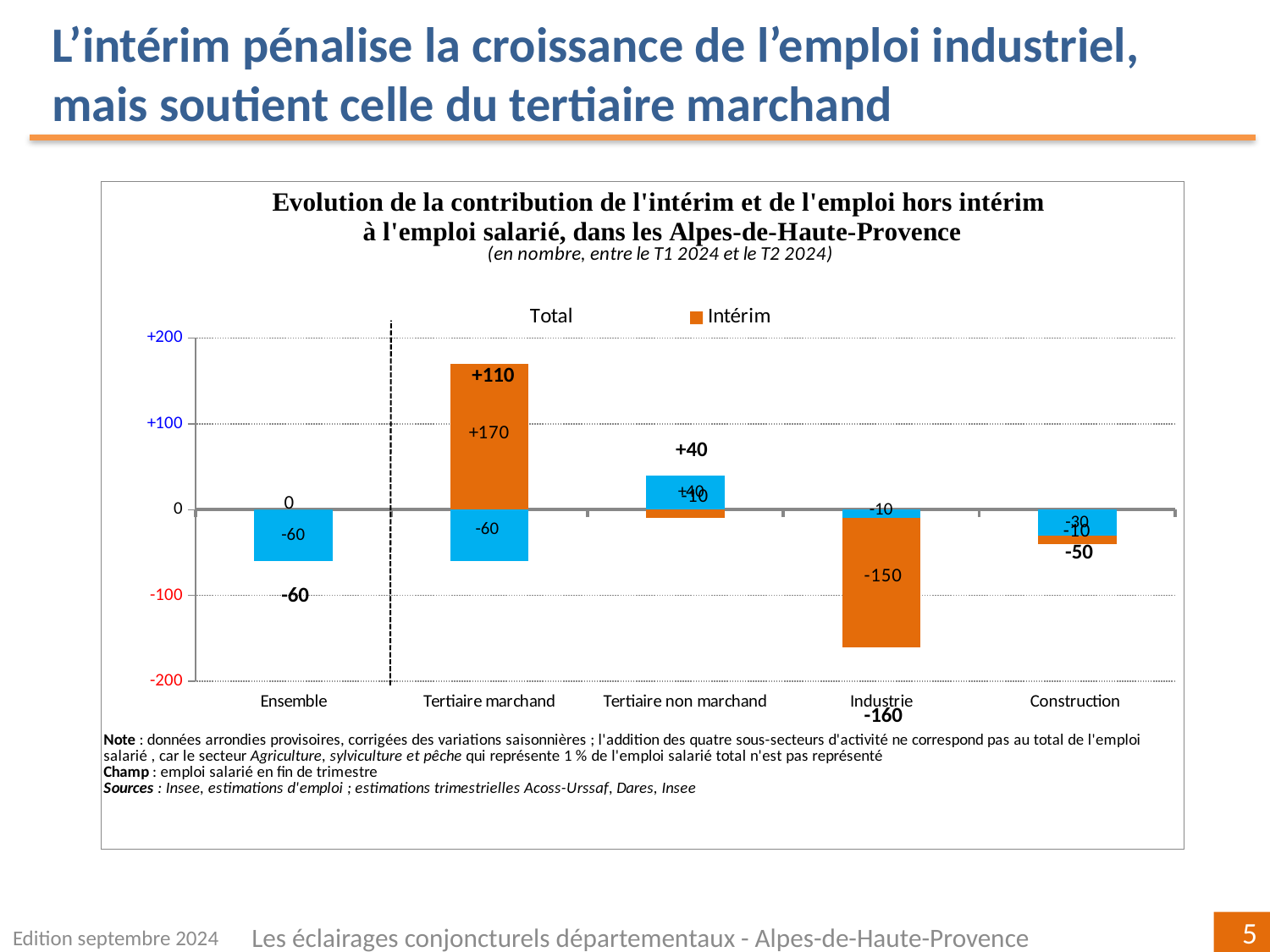
Which sector has the highest total (bold label)? Tertiaire marchand What is the total (bold label) for Tertiaire marchand? +110 What is the total (bold label) for Construction? -50 What is the Intérim value for Industrie? -150 What is the Intérim value for Ensemble? 0 Which département does the chart title say the data is for? Alpes-de-Haute-Provence How many sectors (categories) are shown on the x axis of the chart? 5 What is the total (bold label) for Industrie? -160 What kind of chart is shown on the slide? bar chart Which sector has the lowest total (bold label)? Industrie Which is larger, the Intérim value for Tertiaire marchand or for Industrie? Tertiaire marchand What is the Intérim value for Tertiaire marchand? +170